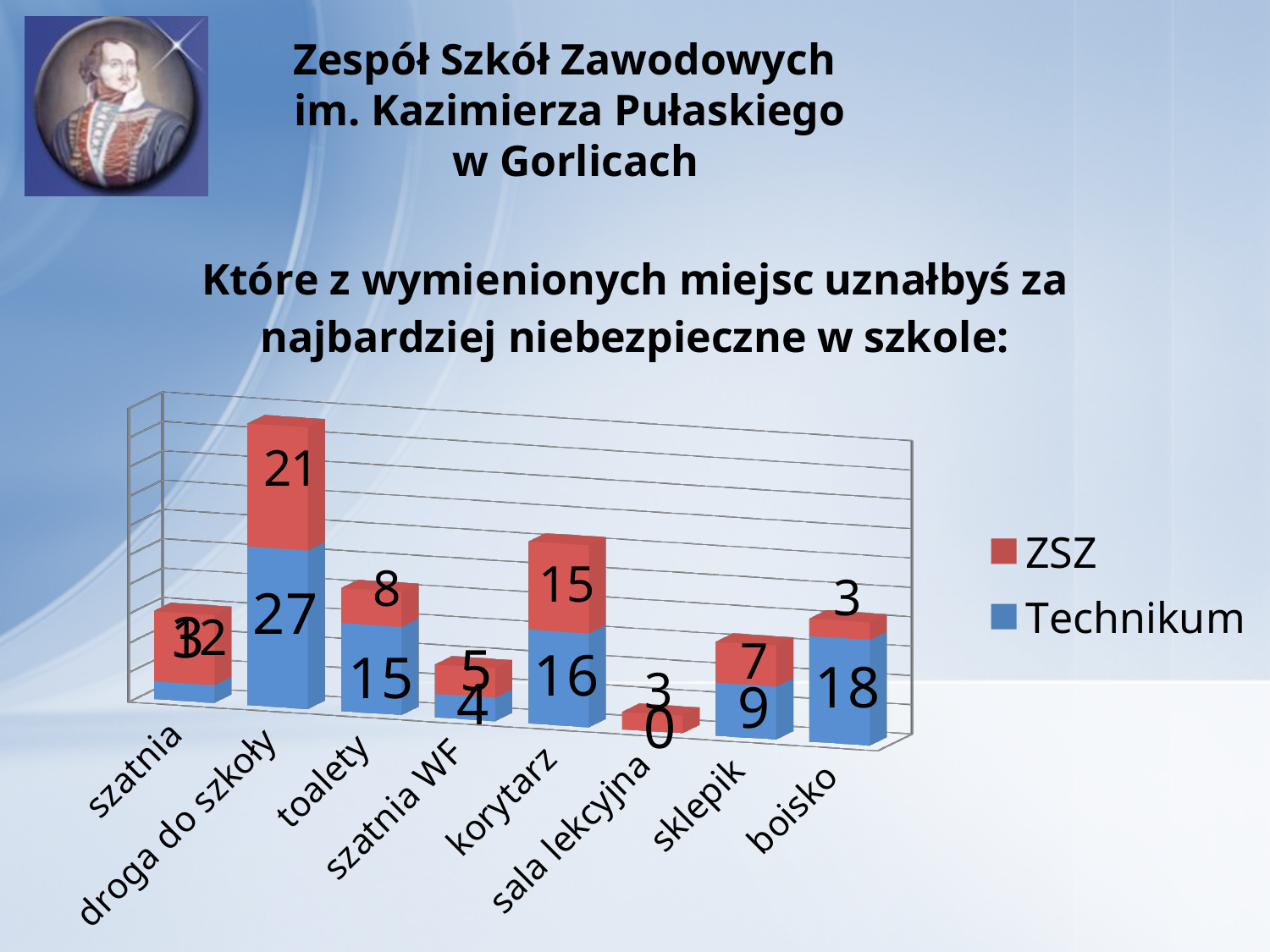
What is the difference between the Technikum and ZSZ values for toalety? 7 What is the Technikum value for boisko? 18 Which is larger for sklepik, the ZSZ value or the Technikum value? Technikum What kind of chart is shown on the slide? bar chart What is the ZSZ value for korytarz? 15 Which category has the shortest stacked bar? sala lekcyjna Which category has the tallest stacked bar? droga do szkoły What is the total of the stacked bar for droga do szkoły? 48 How many categories are shown on the x axis? 8 How many series does the legend list? 2 What is the ZSZ value for sala lekcyjna? 3 What is the Technikum value for droga do szkoły? 27